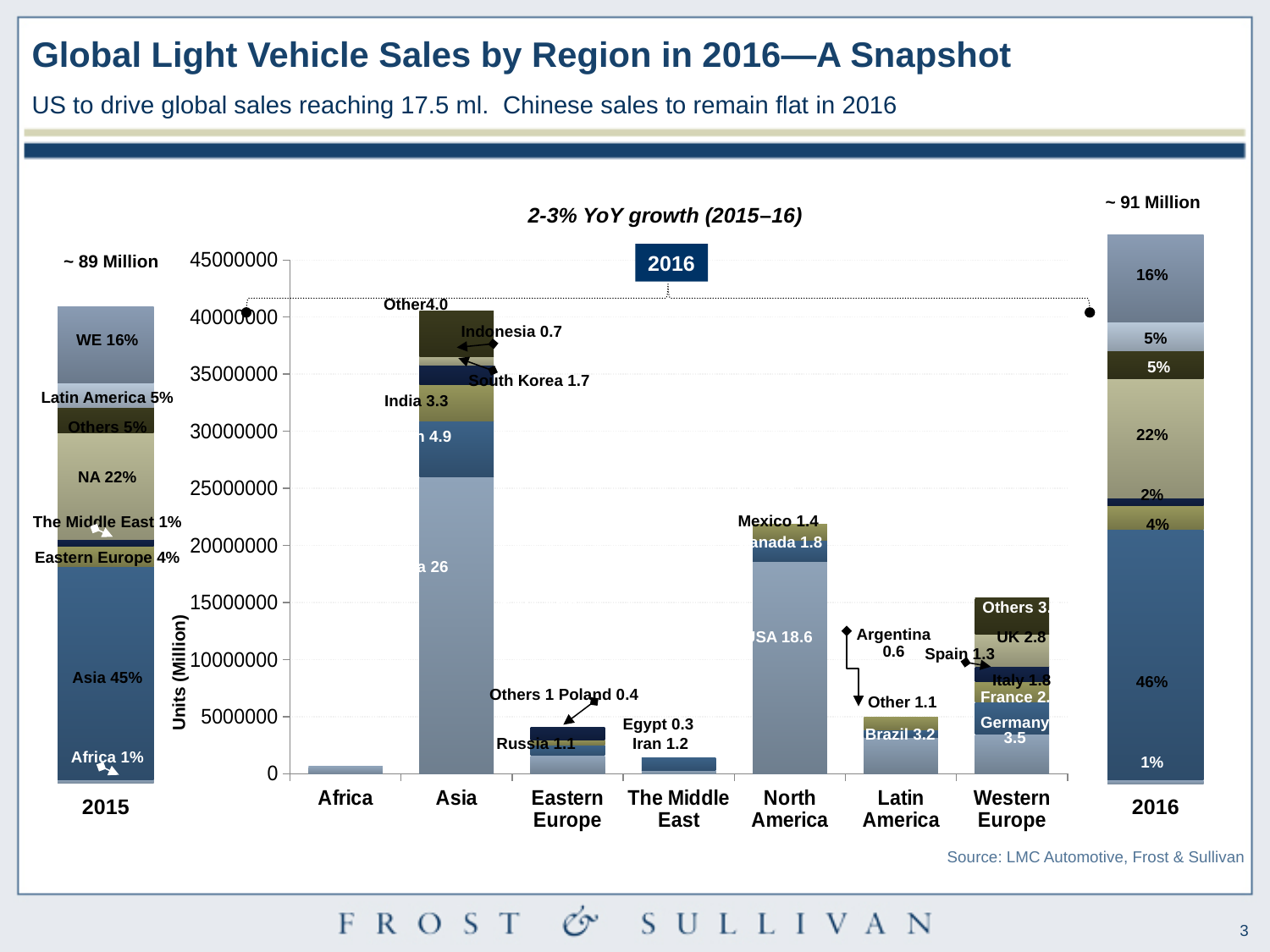
In the central chart by region, is the total for the North America bar greater or less than 20000000? greater In the central chart by region, what is the difference between the values for Canada and Mexico? 0.4 What kind of chart is the central chart showing light vehicle sales by region? bar chart In the central chart by region, which region has the tallest bar? Asia In the 2016 stacked bar on the right, what is the share of the largest segment? 46% In the central chart by region, which region has the shortest bar? Africa In the central chart by region, how many regions are shown on the x axis? 7 In the central chart by region, what is the value labelled for Brazil in the Latin America bar? 3.2 In the central chart by region, which is larger, the value for Germany or the value for UK? Germany In the central chart by region, what is the value labelled for USA in the North America bar? 18.6 In the central chart by region, what is the value labelled for India in the Asia bar? 3.3 In the 2015 stacked bar on the left, what share is labelled for Asia? 45%